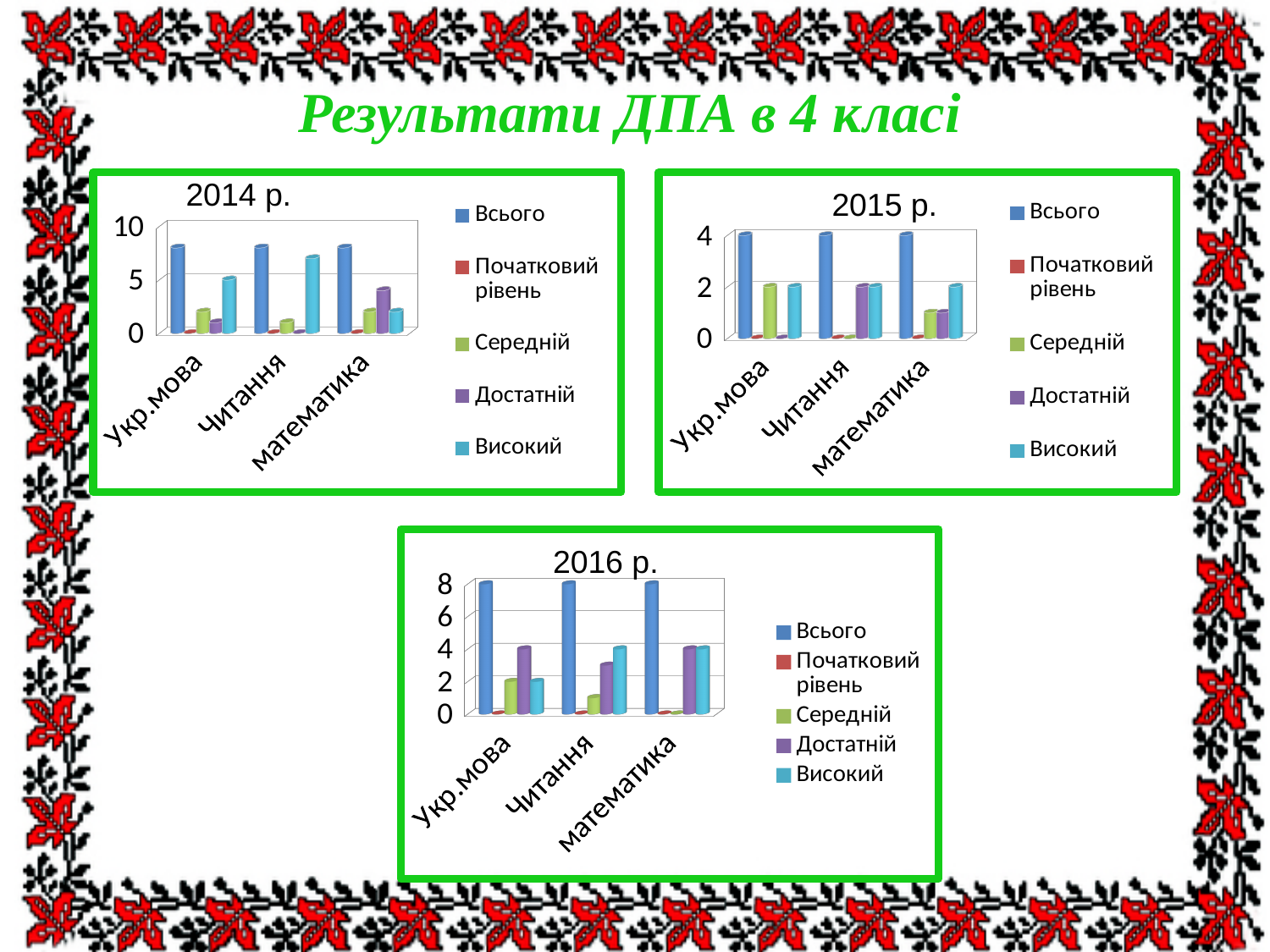
In the 2015 р. chart, is the value of Всього for Читання greater or less than 2? greater In the 2015 р. chart, which is larger: Достатній for Укр.мова or Достатній for Читання? Читання What kind of chart is the 2014 р. chart? bar chart Which series is shown in red in the legend of the 2016 р. chart? Початковий рівень How many series does the legend of the 2015 р. chart list? 5 In the 2014 р. chart, is the value of Високий for математика greater or less than 5? less In the 2014 р. chart, which is larger: Високий for Читання or Високий for математика? Читання In the 2014 р. chart, is the value of Всього for Укр.мова greater or less than 5? greater In the 2014 р. chart, which category has the highest value for Високий? Читання How many categories are shown on the x axis of the 2016 р. chart? 3 In the 2016 р. chart, which category has the lowest value for Середній? математика